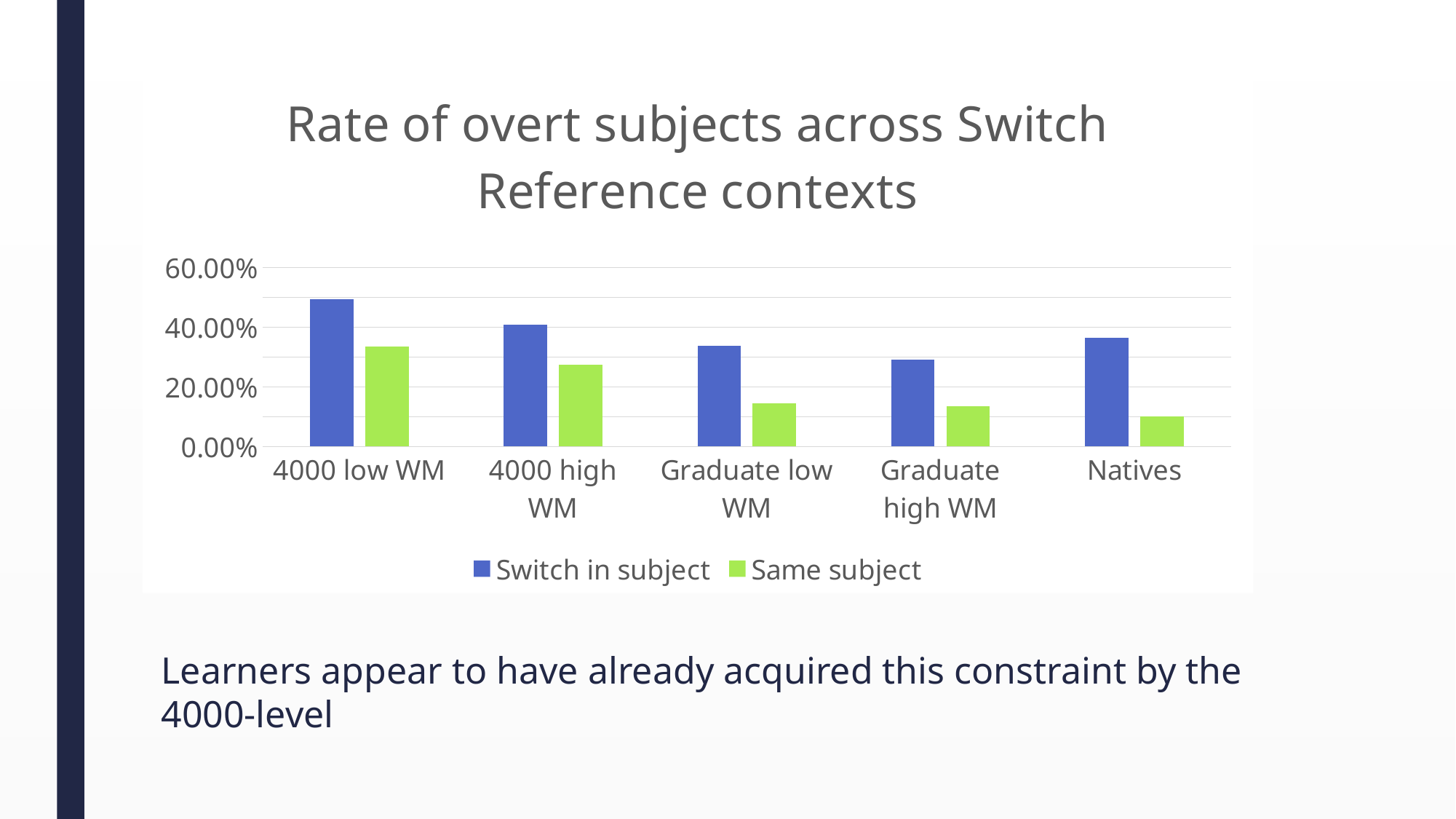
Which category has the highest value for Switch in subject? 4000 low WM What kind of chart is shown on the slide? bar chart Is the Same subject value for 4000 high WM greater or less than 20.00%? greater Is the Switch in subject value for 4000 low WM greater or less than 40.00%? greater Do the Same subject values rise or fall from 4000 low WM to Natives? fall What is the title of the chart? Rate of overt subjects across Switch Reference contexts How many categories are shown along the x axis? 5 Which category has the lowest value for Same subject? Natives Is the Same subject value for Natives greater or less than 20.00%? less For 4000 low WM, which is larger: Switch in subject or Same subject? Switch in subject How many series does the legend list? 2 Which is larger for Switch in subject: Natives or Graduate high WM? Natives